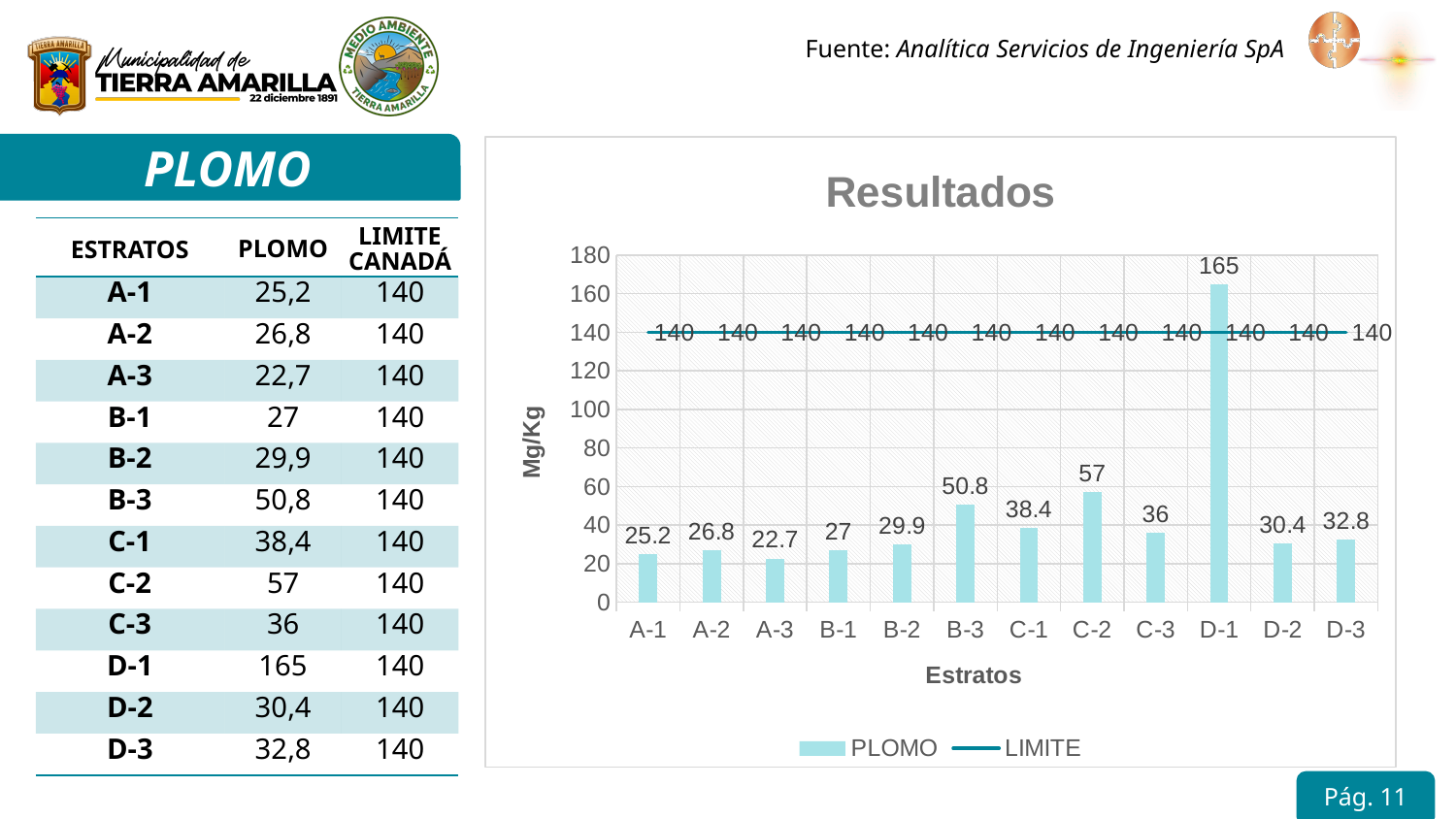
How many estratos are shown on the x axis of the Resultados chart? 12 What is the y-axis label of the Resultados chart? Mg/Kg What is the PLOMO value for A-3 in the Resultados chart? 22.7 What is the PLOMO value for D-1 in the Resultados chart? 165 Which estrato has the highest PLOMO value in the Resultados chart? D-1 How many series does the legend of the Resultados chart list? 2 Is the PLOMO value for D-1 greater or less than the LIMITE of 140? greater What is the PLOMO value for B-3 in the Resultados chart? 50.8 What is the difference between the PLOMO values for D-1 and C-2 in the Resultados chart? 108 Which has a larger PLOMO value in the Resultados chart, C-1 or C-3? C-1 What kind of chart is used for the PLOMO series in the Resultados chart? Bar chart Which estrato has the lowest PLOMO value in the Resultados chart? A-3